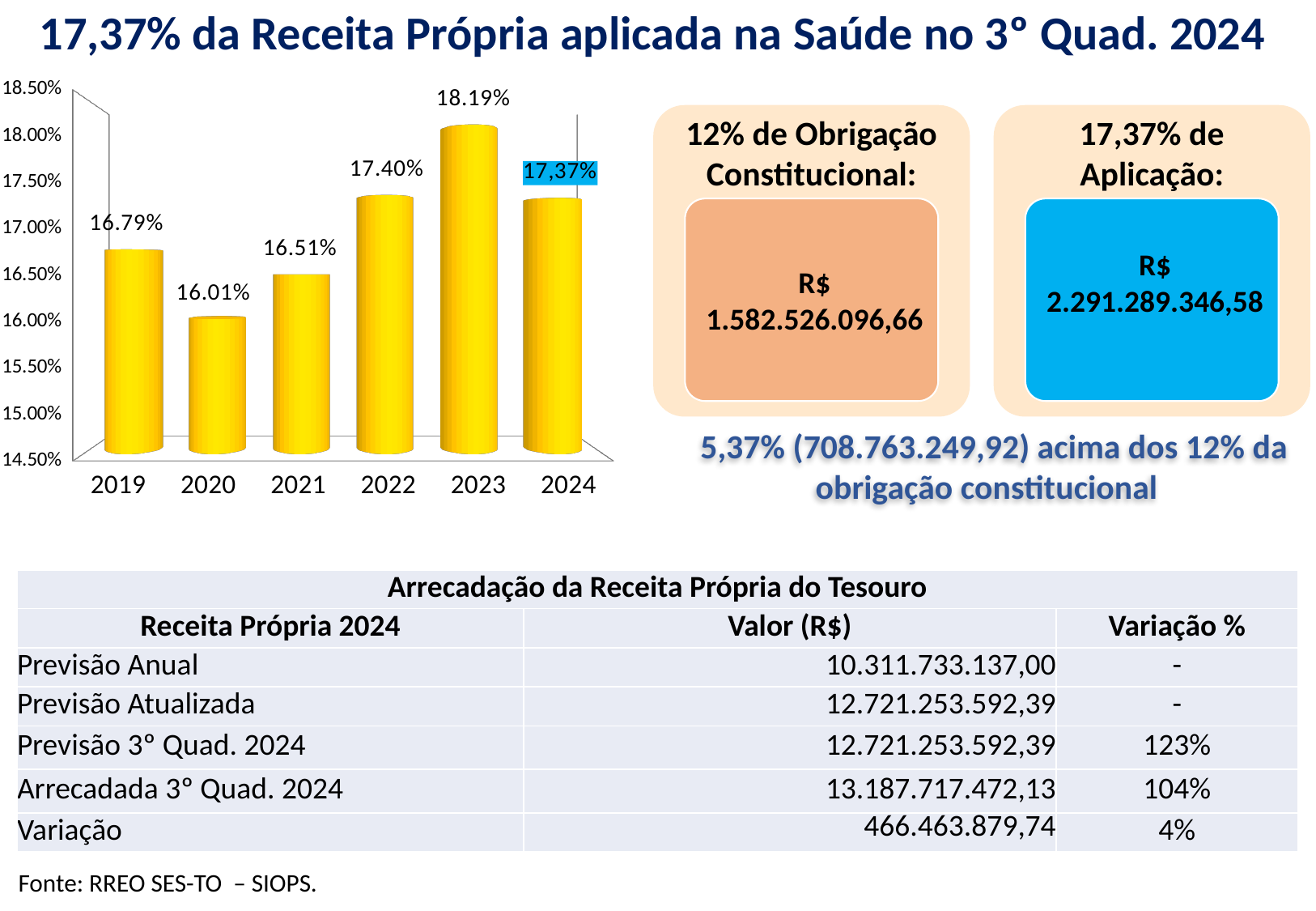
How many years are shown on the x axis of the chart? 6 What kind of chart is shown on the slide? bar chart Do the values rise or fall from 2020 to 2023? rise What value does the chart show for 2024? 17,37% What is the lowest value shown on the chart's vertical axis? 14.50% What value does the chart show for 2023? 18.19% Which year has the highest value in the chart? 2023 Is the value for 2022 greater or less than 17.00%? greater Which is larger, the value for 2021 or the value for 2019? 2019 What value does the chart show for 2019? 16.79% Which year has the lowest value in the chart? 2020 What is the difference between the values for 2023 and 2022? 0.79%